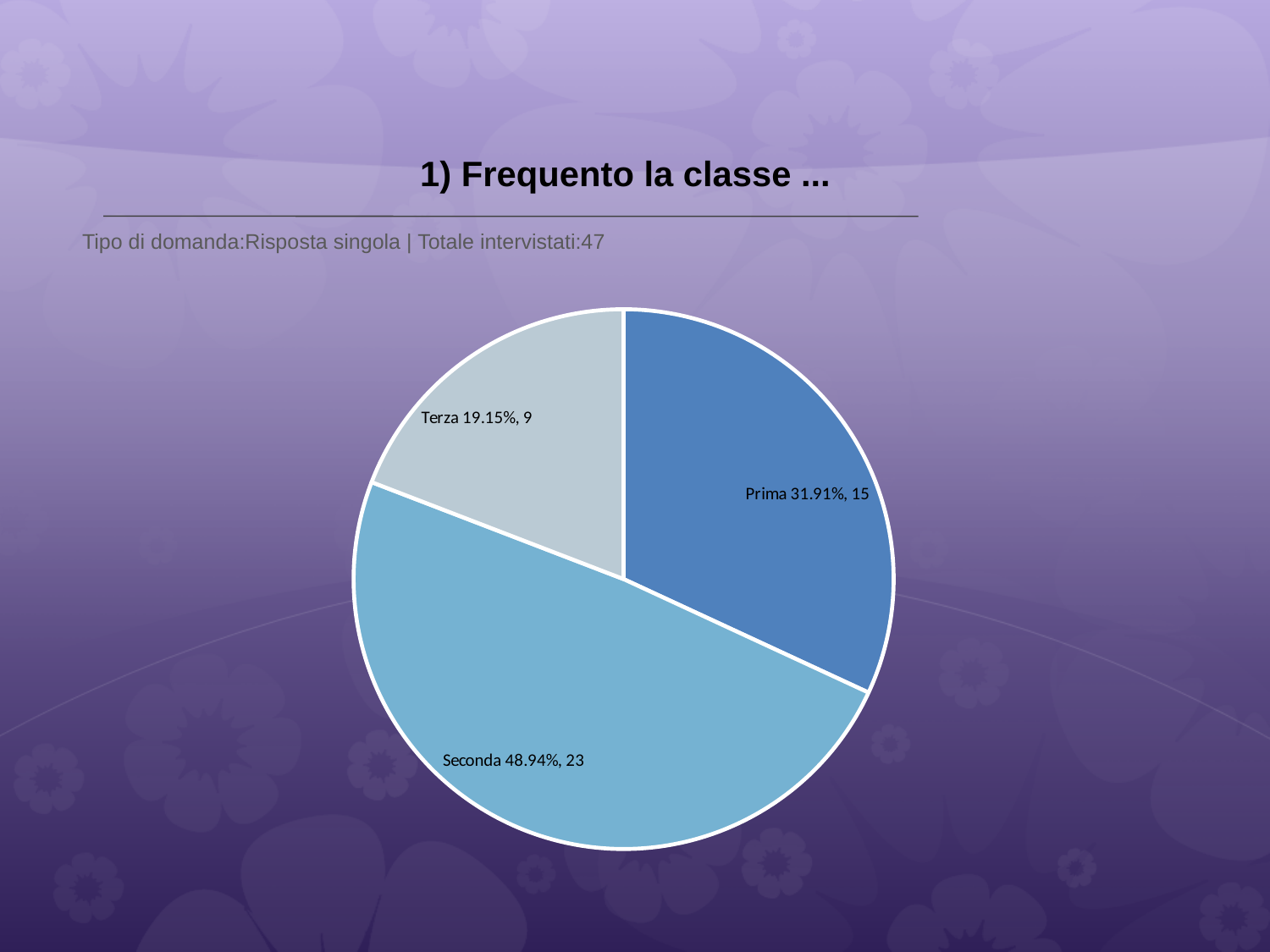
How many slices does the pie chart have? 3 What kind of chart is shown on the slide? pie chart How many more respondents are in Seconda than in Terza? 14 What percentage share does the Terza slice have? 19.15% Which class has the smallest slice of the pie? Terza Which class has the largest slice of the pie? Seconda Which slice is larger, Prima or Terza? Prima What is the title of the chart? 1) Frequento la classe ... How many respondents are in the Prima slice? 15 What is the total number of respondents shown on the slide? 47 What percentage share does the Seconda slice have? 48.94% How many respondents are in the Terza slice? 9